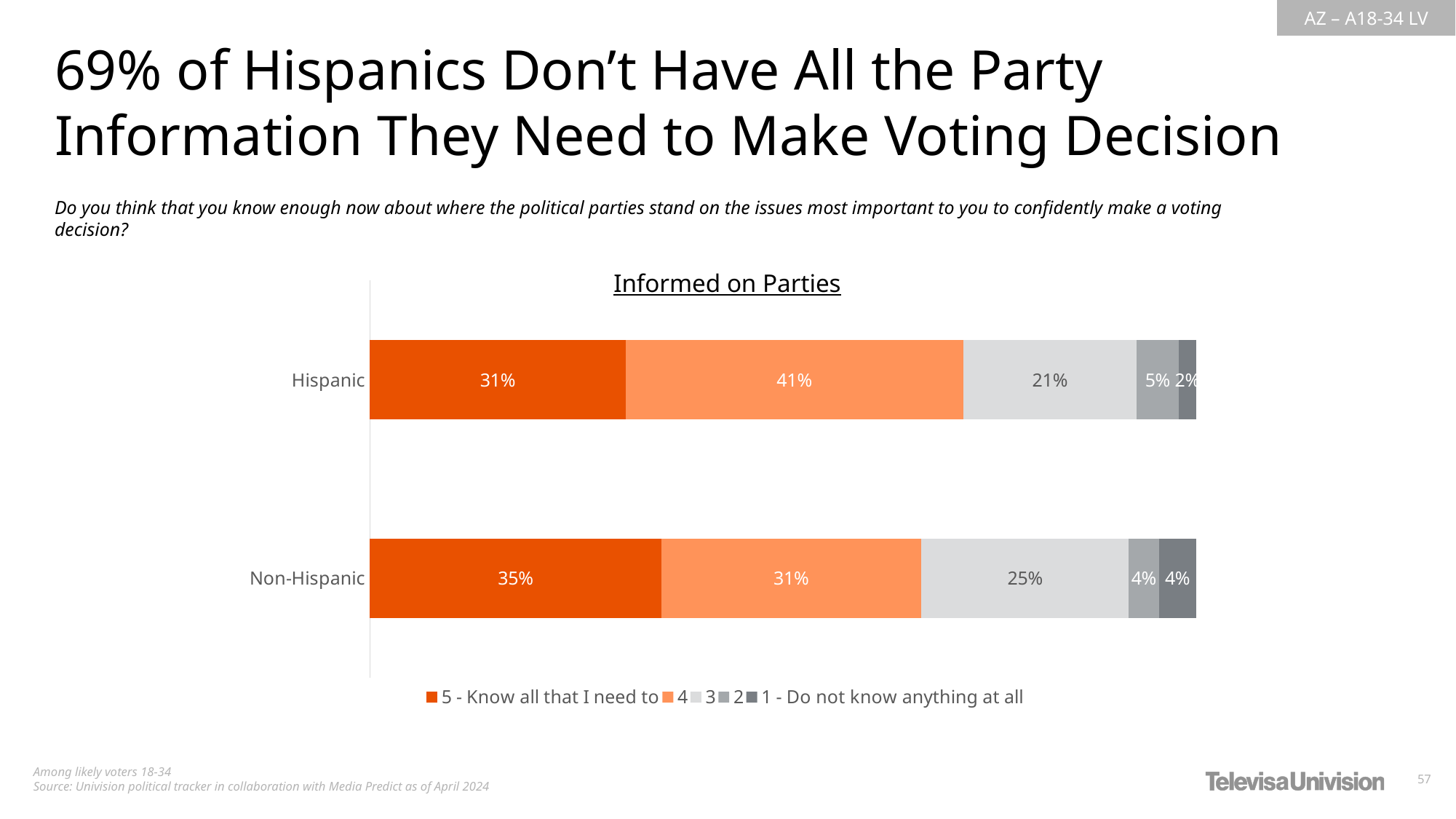
What percentage of Non-Hispanic respondents gave a rating of 3? 25% What is the title of the chart? Informed on Parties What percentage of Non-Hispanic respondents answered '5 - Know all that I need to'? 35% How many series does the legend list? 5 What percentage of Hispanic respondents answered '5 - Know all that I need to'? 31% How many groups (categories) are shown in the chart? 2 What percentage of Hispanic respondents gave a rating of 4? 41% Which group has the larger share answering '5 - Know all that I need to', Hispanic or Non-Hispanic? Non-Hispanic What kind of chart is shown on the slide? Stacked horizontal bar chart What is the difference between the Non-Hispanic and Hispanic shares giving a rating of 3? 4 percentage points What percentage of Hispanic respondents answered '1 - Do not know anything at all'? 2% What is the difference between the Hispanic and Non-Hispanic shares giving a rating of 4? 10 percentage points